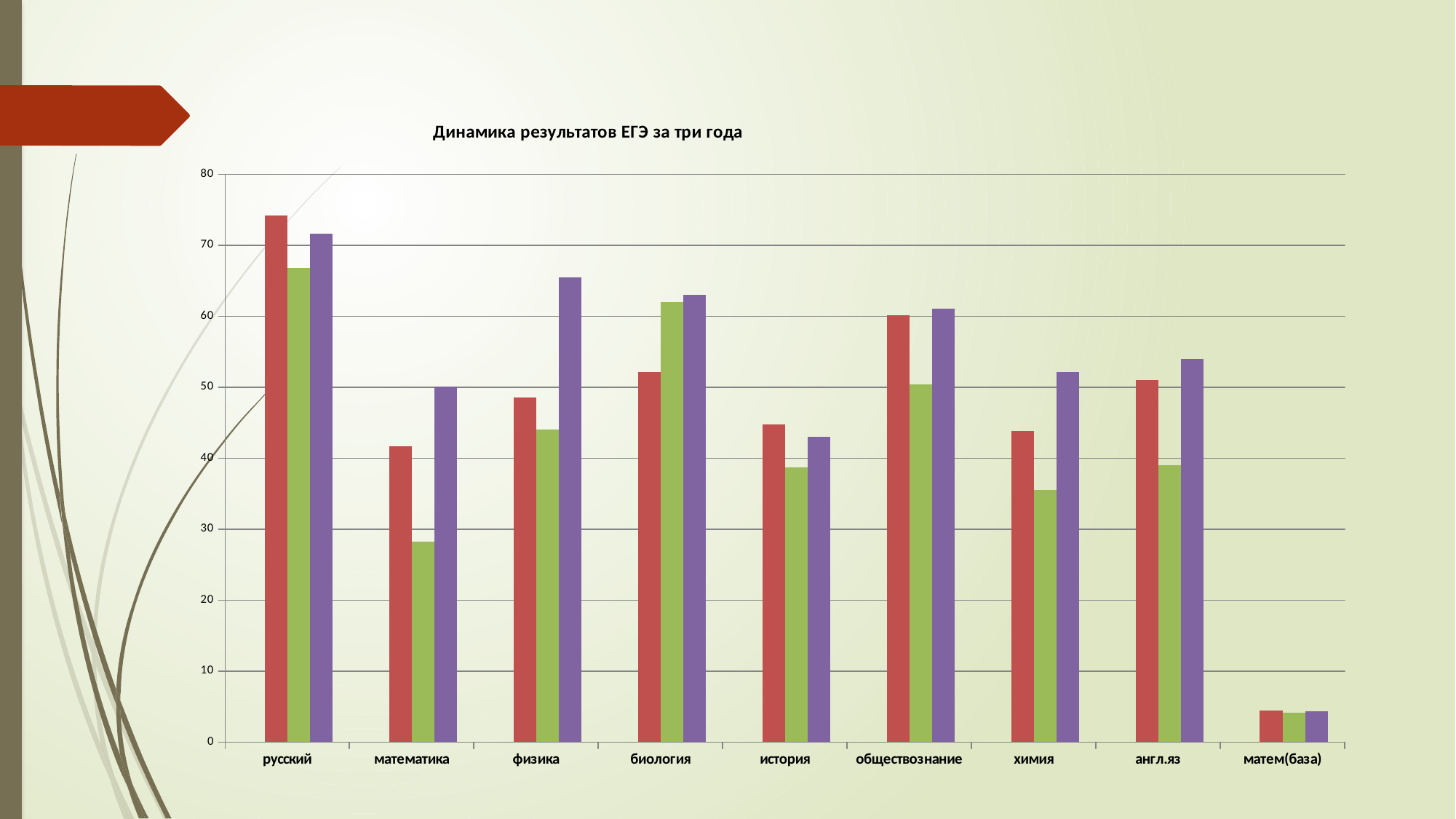
What is the title of the chart? Динамика результатов ЕГЭ за три года For физика, which is larger: the red bar or the purple bar? the purple bar Is the value of the red bar for русский greater or less than 70? greater Which subject category has the highest red bar? русский Is the value of the green bar for химия greater or less than 40? less Is the value of the purple bar for физика greater or less than 60? greater Which subject category has the lowest bars overall? матем(база) How many bars are shown for each subject category? 3 How many subject categories are shown on the x axis? 9 What type of chart is shown on the slide? bar chart